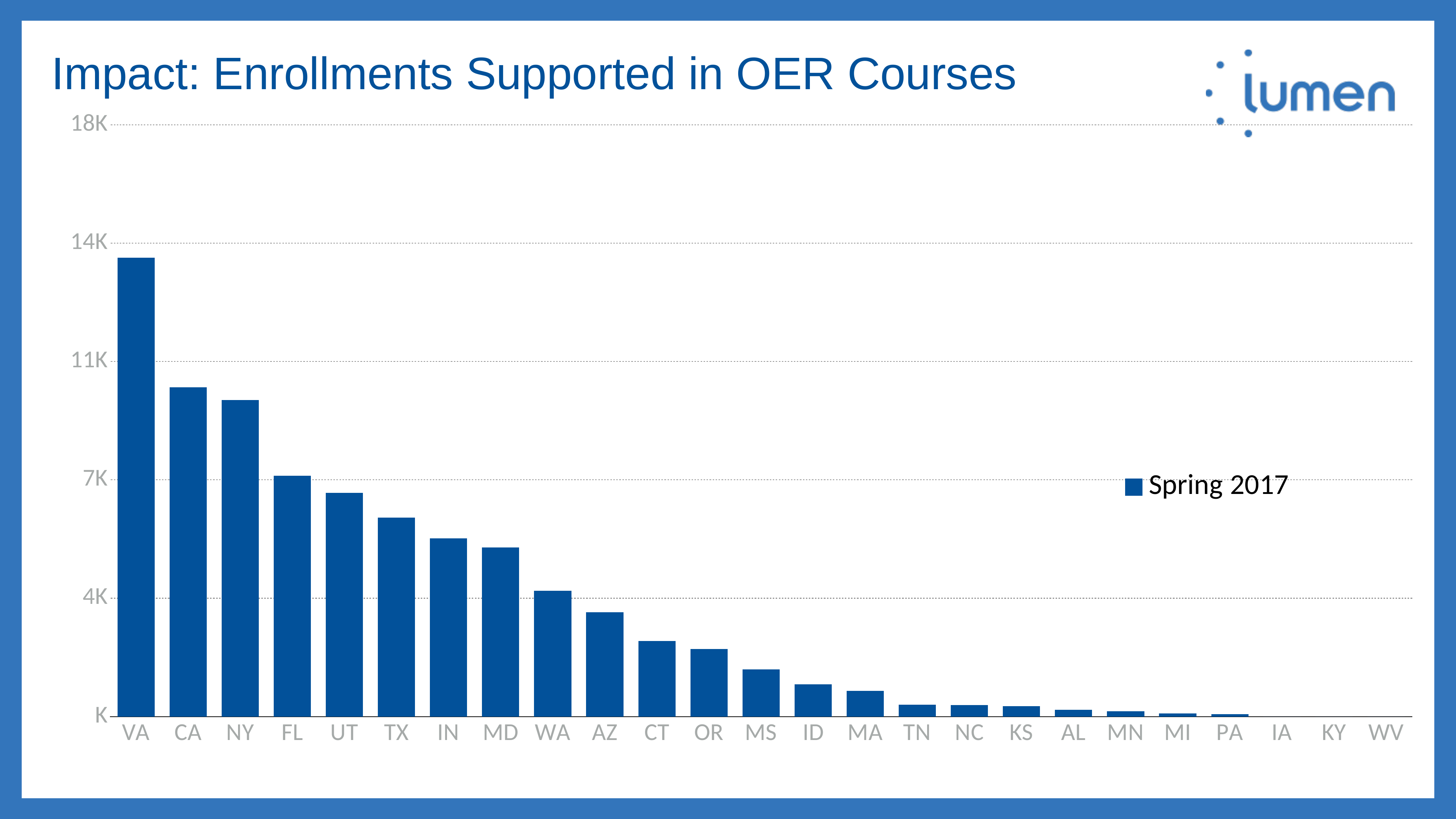
What is the name of the series shown in the legend? Spring 2017 Is the value for IN greater or less than 4K? greater What kind of chart is shown on the slide? bar chart Which state has more enrollments, VA or CA? VA How many series does the legend list? 1 Is the value for CA greater or less than 11K? less Do the values rise or fall moving from left to right along the x axis? fall Is the value for VA greater or less than 11K? greater How many states are shown on the x axis of the chart? 25 Which state has the highest number of enrollments in the chart? VA